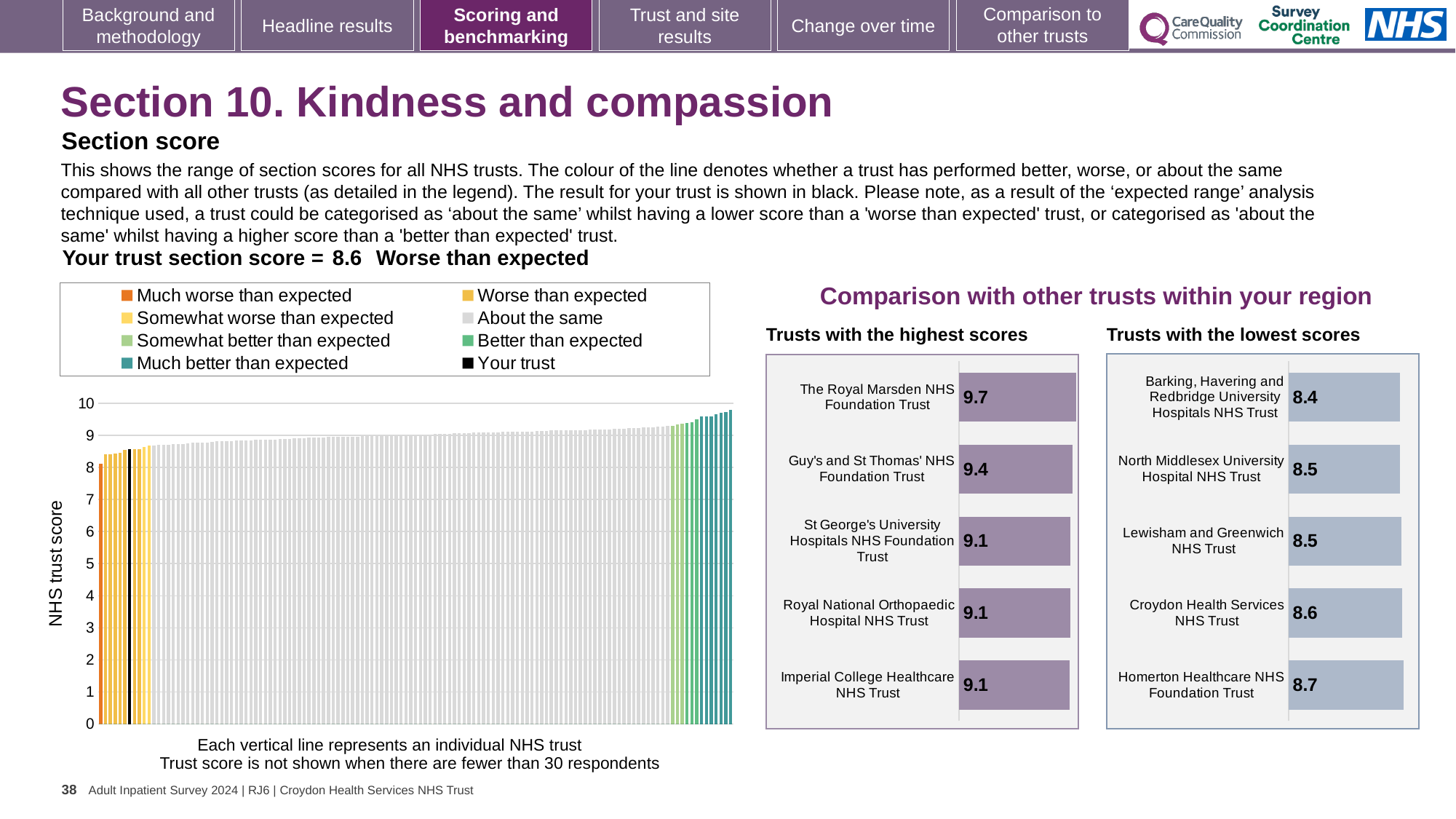
What kind of chart is the main chart showing the NHS trust scores for all trusts? Bar chart In the 'Trusts with the lowest scores' chart, what is the difference between the scores of Homerton Healthcare NHS Foundation Trust and Barking, Havering and Redbridge University Hospitals NHS Trust? 0.3 In the 'Trusts with the lowest scores' chart, which has the higher score: Homerton Healthcare NHS Foundation Trust or Croydon Health Services NHS Trust? Homerton Healthcare NHS Foundation Trust How many trusts are shown in the 'Trusts with the highest scores' chart? 5 In the main NHS trust score chart, do the values rise or fall from left to right? Rise In the 'Trusts with the lowest scores' chart, what is the score for Barking, Havering and Redbridge University Hospitals NHS Trust? 8.4 In the 'Trusts with the highest scores' chart, what is the score for The Royal Marsden NHS Foundation Trust? 9.7 In the 'Trusts with the highest scores' chart, which trust has the highest score? The Royal Marsden NHS Foundation Trust What is the label on the vertical axis of the main chart showing all NHS trusts? NHS trust score In the 'Trusts with the lowest scores' chart, which trust has the lowest score? Barking, Havering and Redbridge University Hospitals NHS Trust In the 'Trusts with the highest scores' chart, what is the difference between the scores of The Royal Marsden NHS Foundation Trust and Guy's and St Thomas' NHS Foundation Trust? 0.3 How many entries does the legend of the main NHS trust score chart list? 8